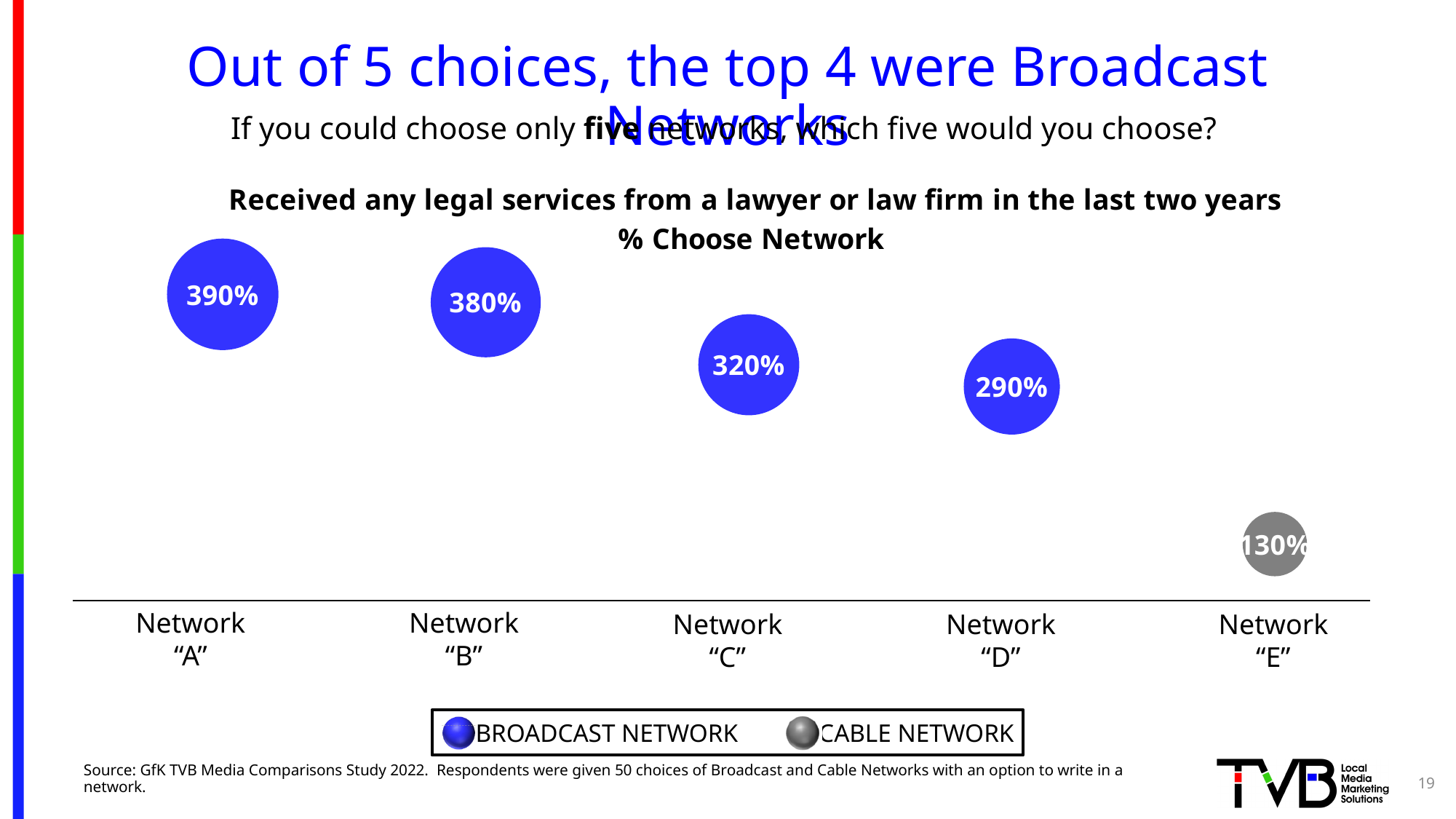
Which network has the lowest value? Network "E" What is the value for Network "C"? 320% How many networks are plotted on the chart? 5 Do the values rise or fall from Network "A" to Network "E"? fall What is the value for Network "A"? 390% What is the difference between the values for Network "A" and Network "E"? 260% Which is larger, the value for Network "C" or the value for Network "D"? Network "C" What is the difference between the values for Network "B" and Network "D"? 90% Which network has the highest value? Network "A" How many series does the legend list? 2 Which network is shown as a Cable Network in the chart? Network "E" What is the value for Network "E"? 130%